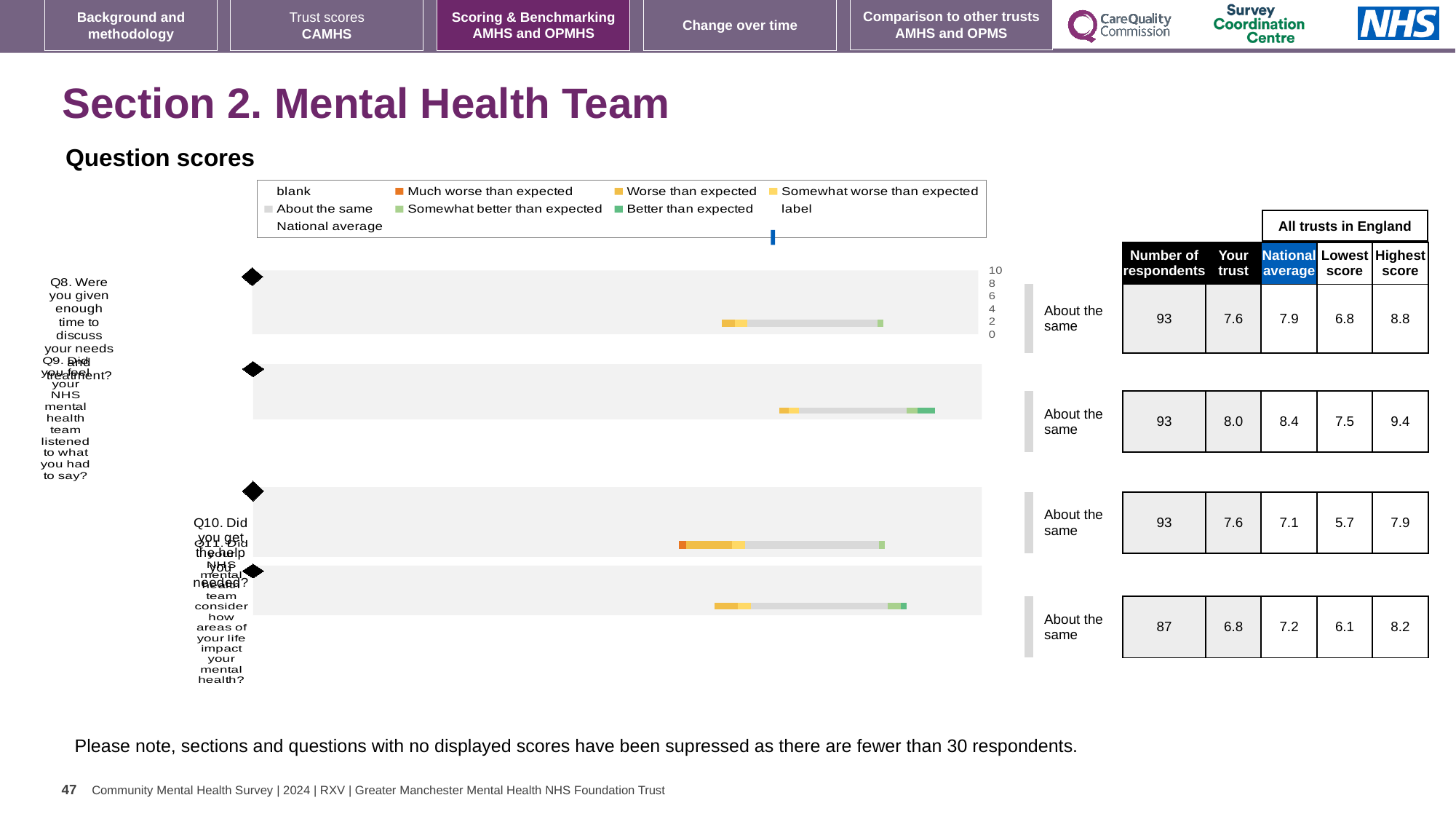
For Q10, which is larger: the 'Your trust' score or the national average? Your trust In the table, what is the lowest score among all trusts in England for Q10 (Did you get the help you needed?)? 5.7 What kind of chart is used to show the question scores on this slide? bar chart What is the difference between the national average and the 'Your trust' score for Q9? 0.4 In the table, what is the 'Your trust' score for Q8 (Were you given enough time to discuss your needs and treatment?)? 7.6 In the table, how many respondents are listed for Q11 (Did your NHS mental health team consider how areas of your life impact your mental health?)? 87 How many questions (bars) are plotted in the question scores chart? 4 What is the title shown above the chart? Question scores In the table, what is the highest score among all trusts in England for Q9? 9.4 In the table, what is the national average for Q9 (Did you feel your NHS mental health team listened to what you had to say?)? 8.4 Which question has the lowest 'Your trust' score in the table? Q11 Which question has the highest 'Your trust' score in the table? Q9